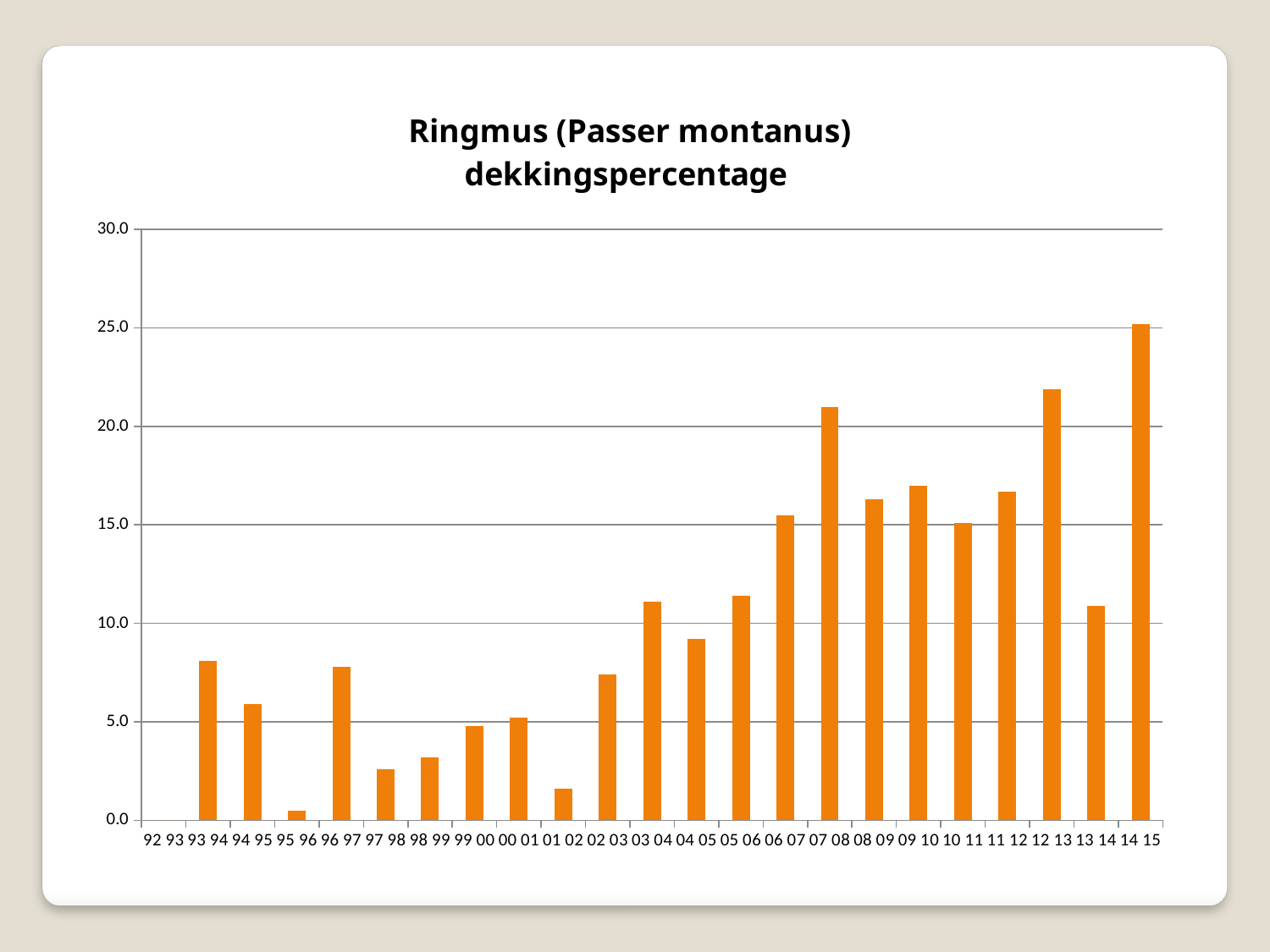
Is the value for 06 07 greater or less than 15.0? greater How many periods are listed along the x axis? 23 Which period has the highest bar? 14 15 Is the value for 07 08 greater or less than 20.0? greater What is the title of the chart? Ringmus (Passer montanus) dekkingspercentage Which is larger, the value for 09 10 or the value for 10 11? 09 10 Is the value for 04 05 greater or less than 10.0? less Do the values generally rise or fall from 92 93 to 14 15? rise What kind of chart is shown on the slide? bar chart Which is larger, the value for 14 15 or the value for 12 13? 14 15